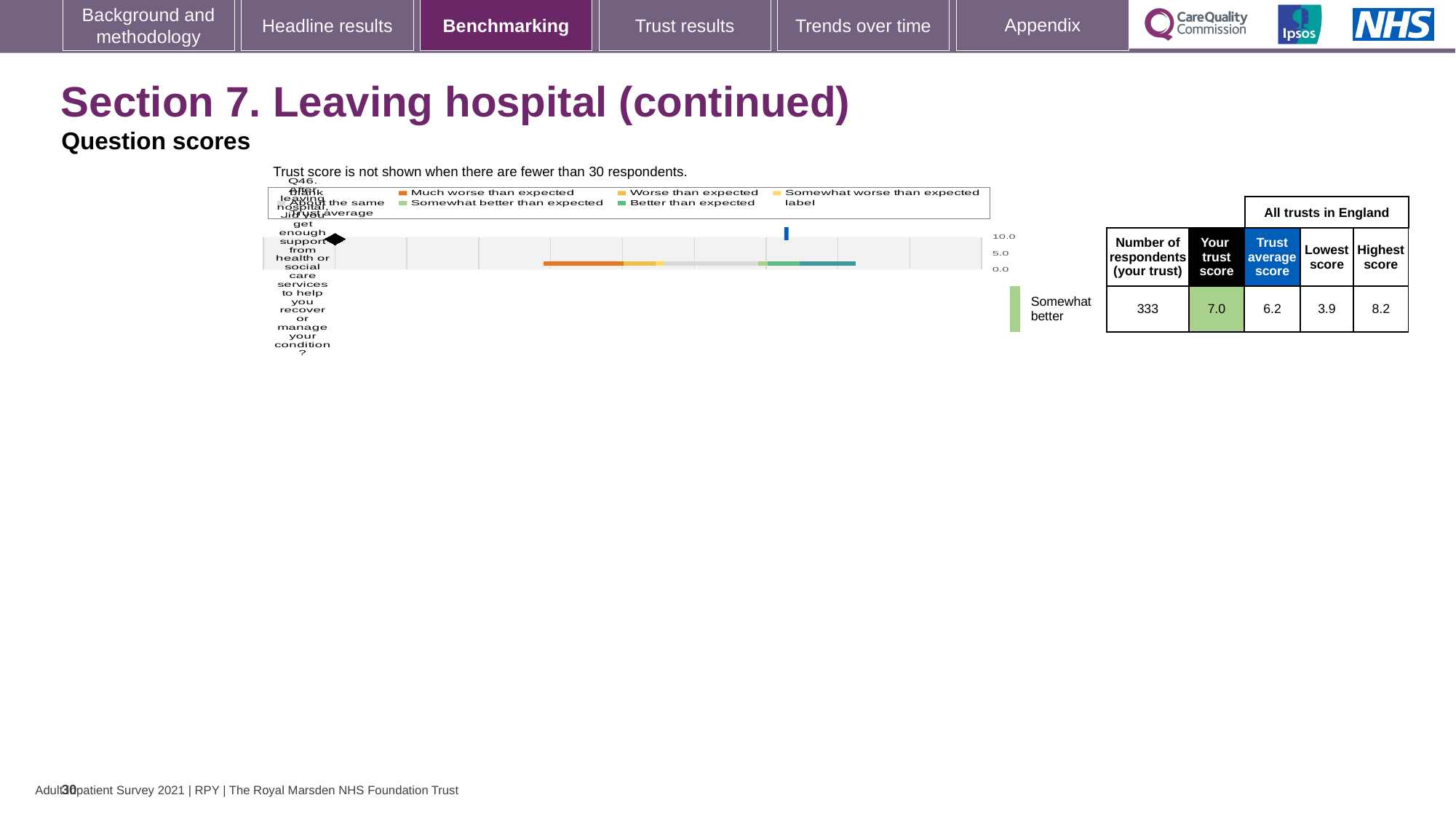
What kind of chart is shown on the slide? bar chart What rating label is shown next to the chart for your trust's Q46 result? Somewhat better In the table beside the chart, what is the trust average score for Q46? 6.2 What is the difference between the highest score and the lowest score among all trusts in England for Q46? 4.3 How many questions (categories) are plotted in the chart? 1 In the table beside the chart, what is the lowest score among all trusts in England? 3.9 In the table beside the chart, what is the number of respondents for your trust? 333 In the table beside the chart, what is your trust score for Q46? 7.0 Is your trust score for Q46 higher or lower than the trust average score? higher What is the highest tick value shown on the chart's axis? 10.0 In the table beside the chart, what is the highest score among all trusts in England? 8.2 Which colour does the chart legend use for 'Much worse than expected'? orange